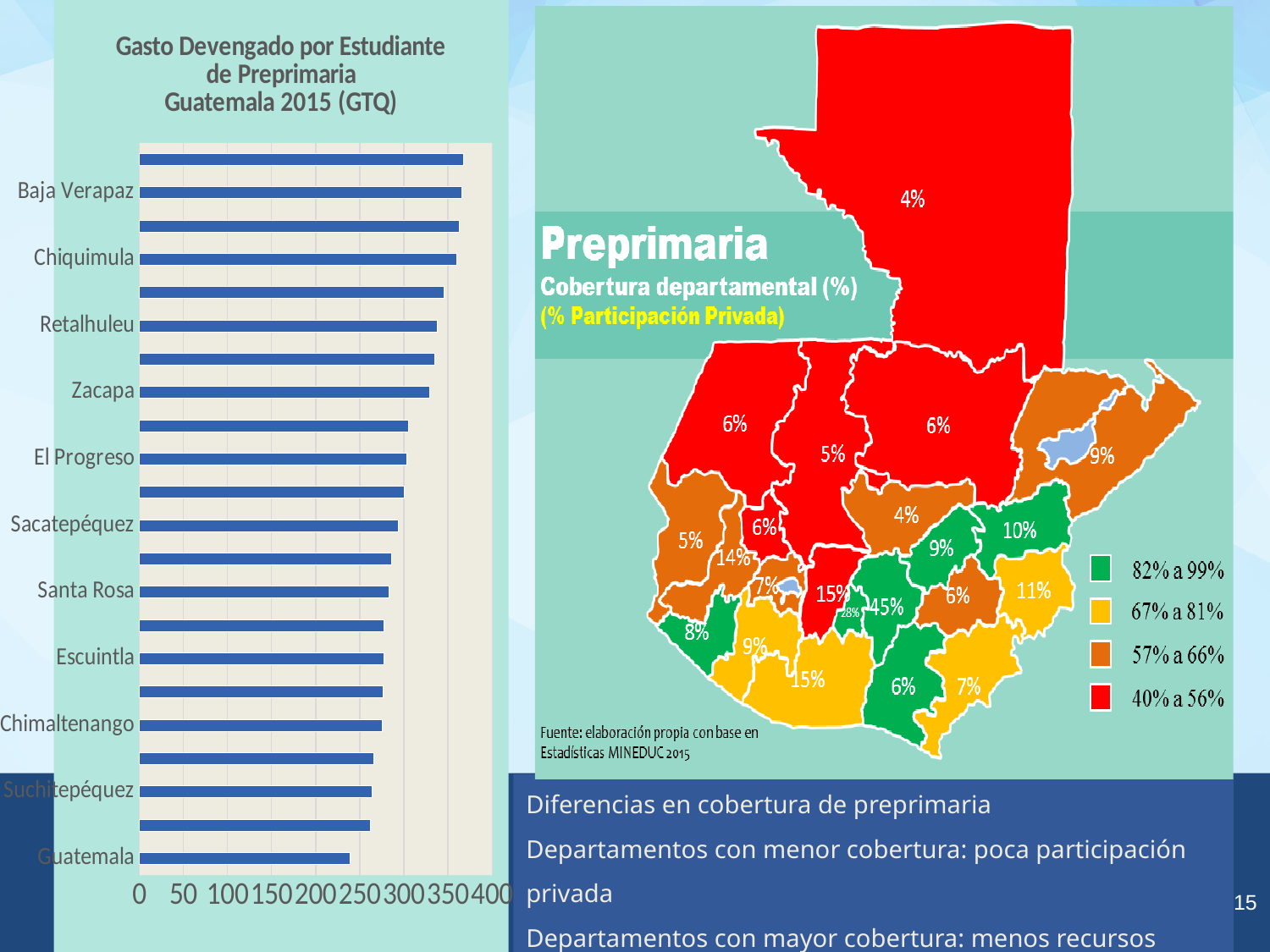
In the bar chart, which has a higher value, Retalhuleu or Santa Rosa? Retalhuleu In the bar chart, which has a higher value, Baja Verapaz or Guatemala? Baja Verapaz What is the title of the bar chart on the left of the slide? Gasto Devengado por Estudiante de Preprimaria Guatemala 2015 (GTQ) In the bar chart, which labelled department has the lowest spending per student? Guatemala What kind of chart is shown on the left of the slide? bar chart In the bar chart, is the value for Chimaltenango greater or less than 250? greater In the bar chart, is the value for Guatemala greater or less than 300? less In the bar chart, do the bar values increase or decrease going from the top of the chart to the bottom? decrease What is the highest value shown on the horizontal axis of the bar chart? 400 In the bar chart, is the value for Retalhuleu greater or less than 300? greater